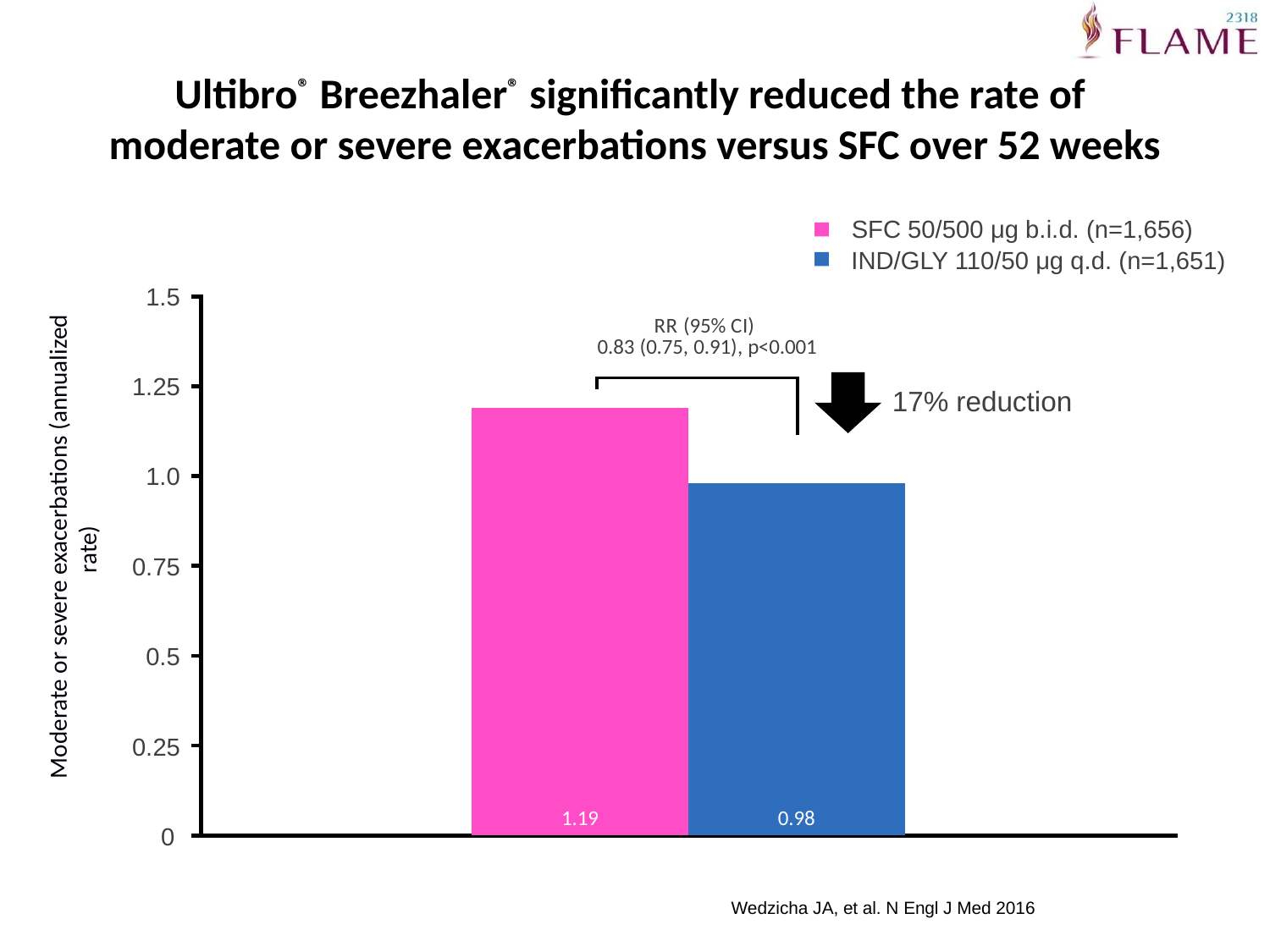
How many series does the legend list? 2 How many bars are plotted in the chart? 2 Which treatment group has the lower annualized exacerbation rate? IND/GLY 110/50 µg q.d. What is the difference between the SFC and IND/GLY annualized exacerbation rates? 0.21 What is the annualized rate of moderate or severe exacerbations for IND/GLY 110/50 µg q.d.? 0.98 Which treatment group has the higher annualized exacerbation rate? SFC 50/500 µg b.i.d. What type of chart is shown on the slide? Bar chart Is the annualized exacerbation rate for IND/GLY greater or less than 1.0? less What is the annualized rate of moderate or severe exacerbations for SFC 50/500 µg b.i.d.? 1.19 What percentage reduction is annotated on the chart? 17% reduction Is the annualized exacerbation rate for SFC greater or less than 1.0? greater What is the rate ratio (95% CI) shown on the chart? 0.83 (0.75, 0.91), p<0.001